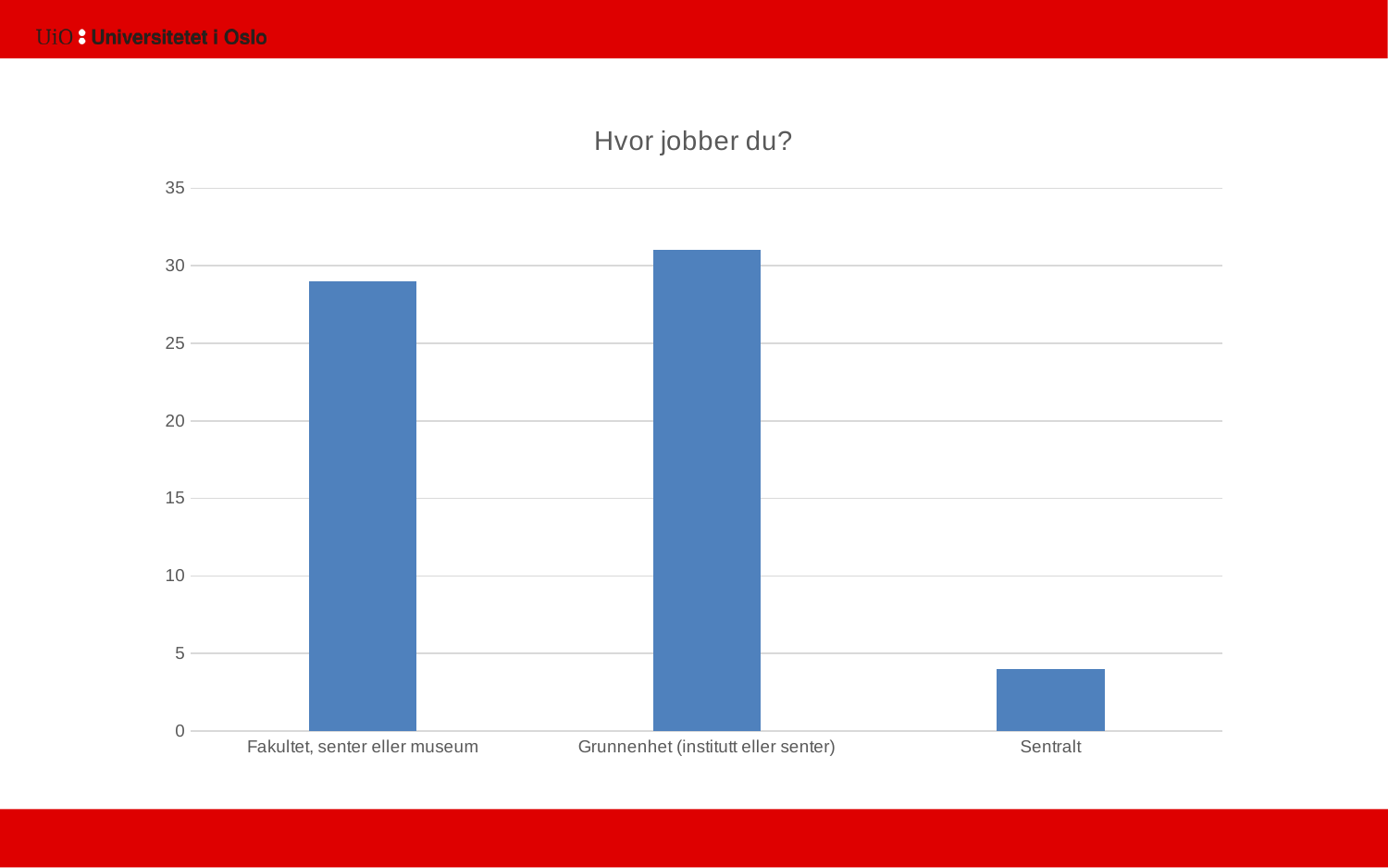
Is the value for Grunnenhet (institutt eller senter) greater or less than 25? greater Is the value for Fakultet, senter eller museum greater or less than 25? greater What is the title of the chart? Hvor jobber du? How many categories are shown on the x axis of the chart? 3 What is the highest value shown on the y axis of the chart? 35 Which category has the lowest value in the chart? Sentralt Is the value for Fakultet, senter eller museum greater or less than 35? less Which is larger, the value for Fakultet, senter eller museum or the value for Sentralt? Fakultet, senter eller museum Which is larger, the value for Grunnenhet (institutt eller senter) or the value for Sentralt? Grunnenhet (institutt eller senter) What kind of chart is shown on the slide? bar chart Which category has the highest value in the chart? Grunnenhet (institutt eller senter)